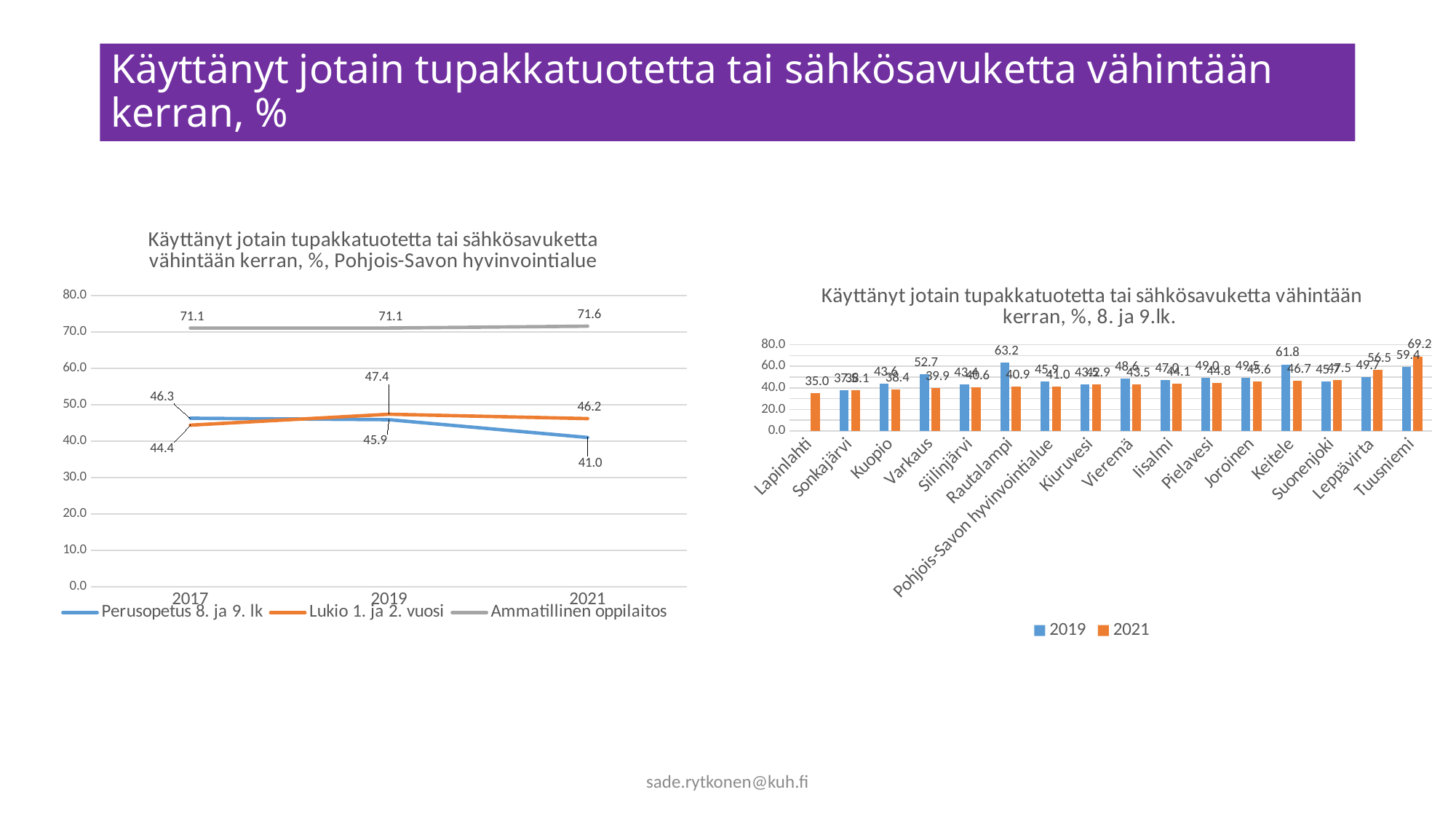
On the right chart (8. ja 9.lk.), which category has the highest 2019 value? Rautalampi On the right chart (8. ja 9.lk.), how many categories are shown on the x axis? 16 On the right chart (8. ja 9.lk.), which is larger for Keitele, the 2019 value or the 2021 value? 2019 On the left chart (Pohjois-Savon hyvinvointialue), what is the value for Ammatillinen oppilaitos in 2021? 71.6 On the left chart (Pohjois-Savon hyvinvointialue), how many series does the legend list? 3 On the left chart (Pohjois-Savon hyvinvointialue), what is the value for Lukio 1. ja 2. vuosi in 2019? 47.4 On the left chart (Pohjois-Savon hyvinvointialue), does the value for Perusopetus 8. ja 9. lk rise or fall from 2017 to 2021? fall On the left chart (Pohjois-Savon hyvinvointialue), what is the difference between Ammatillinen oppilaitos and Perusopetus 8. ja 9. lk in 2021? 30.6 What kind of chart is the right chart (8. ja 9.lk.)? bar chart On the right chart (8. ja 9.lk.), what is the 2019 value for Rautalampi? 63.2 On the left chart (Pohjois-Savon hyvinvointialue), what is the value for Perusopetus 8. ja 9. lk in 2021? 41.0 On the right chart (8. ja 9.lk.), what is the 2021 value for Tuusniemi? 69.2